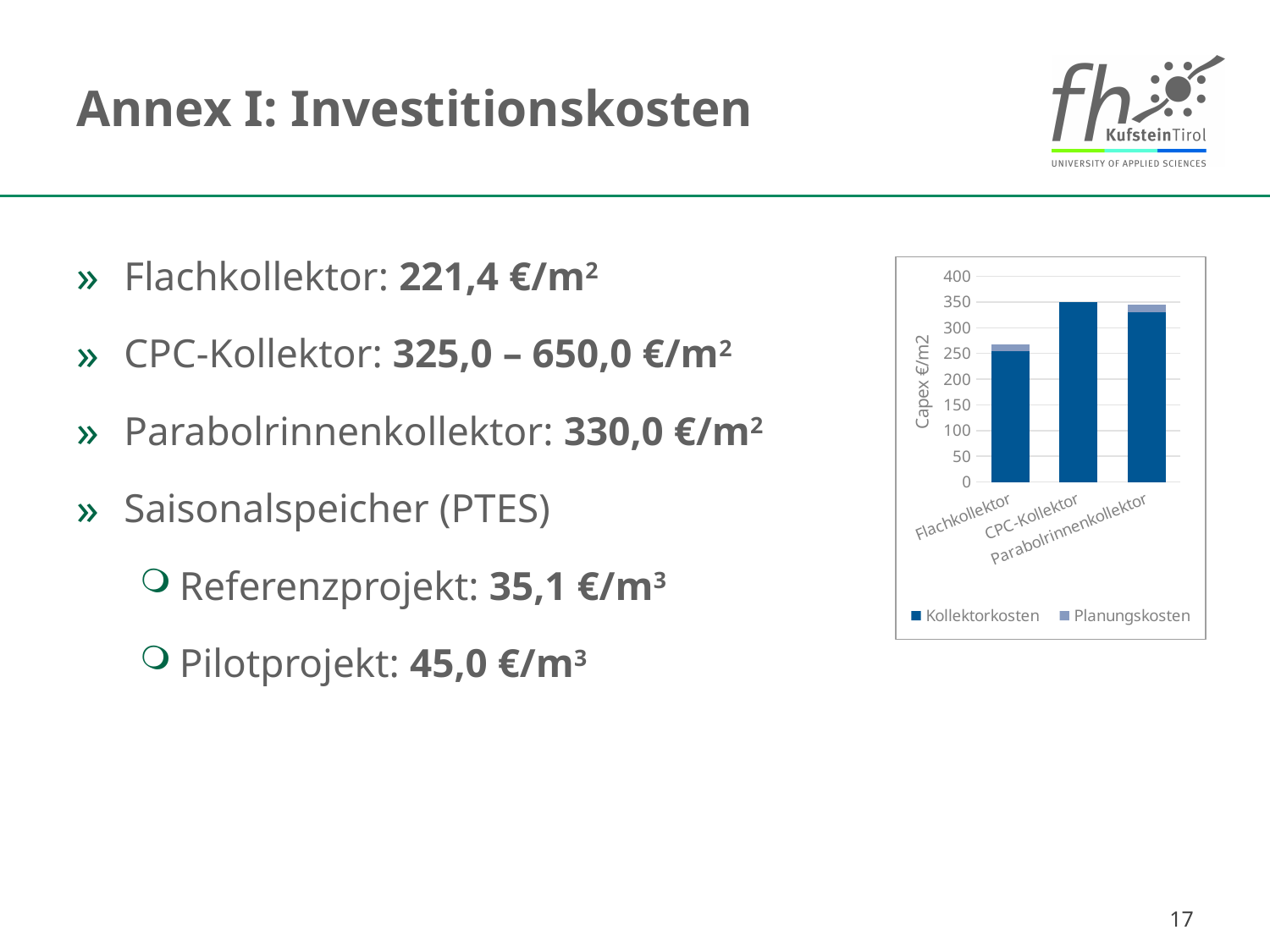
Is the total bar for CPC-Kollektor greater or less than 400? less Which is larger, the total bar for Flachkollektor or the total bar for CPC-Kollektor? CPC-Kollektor How many series does the chart legend list? 2 What are the two series named in the chart legend? Kollektorkosten and Planungskosten What kind of chart is shown on the slide? stacked bar chart Is the total bar for CPC-Kollektor greater or less than 300? greater Is the total bar for Parabolrinnenkollektor greater or less than 300? greater Which category has the lowest total bar in the chart? Flachkollektor How many categories are shown on the x axis of the chart? 3 What is the label of the y axis of the chart? Capex €/m2